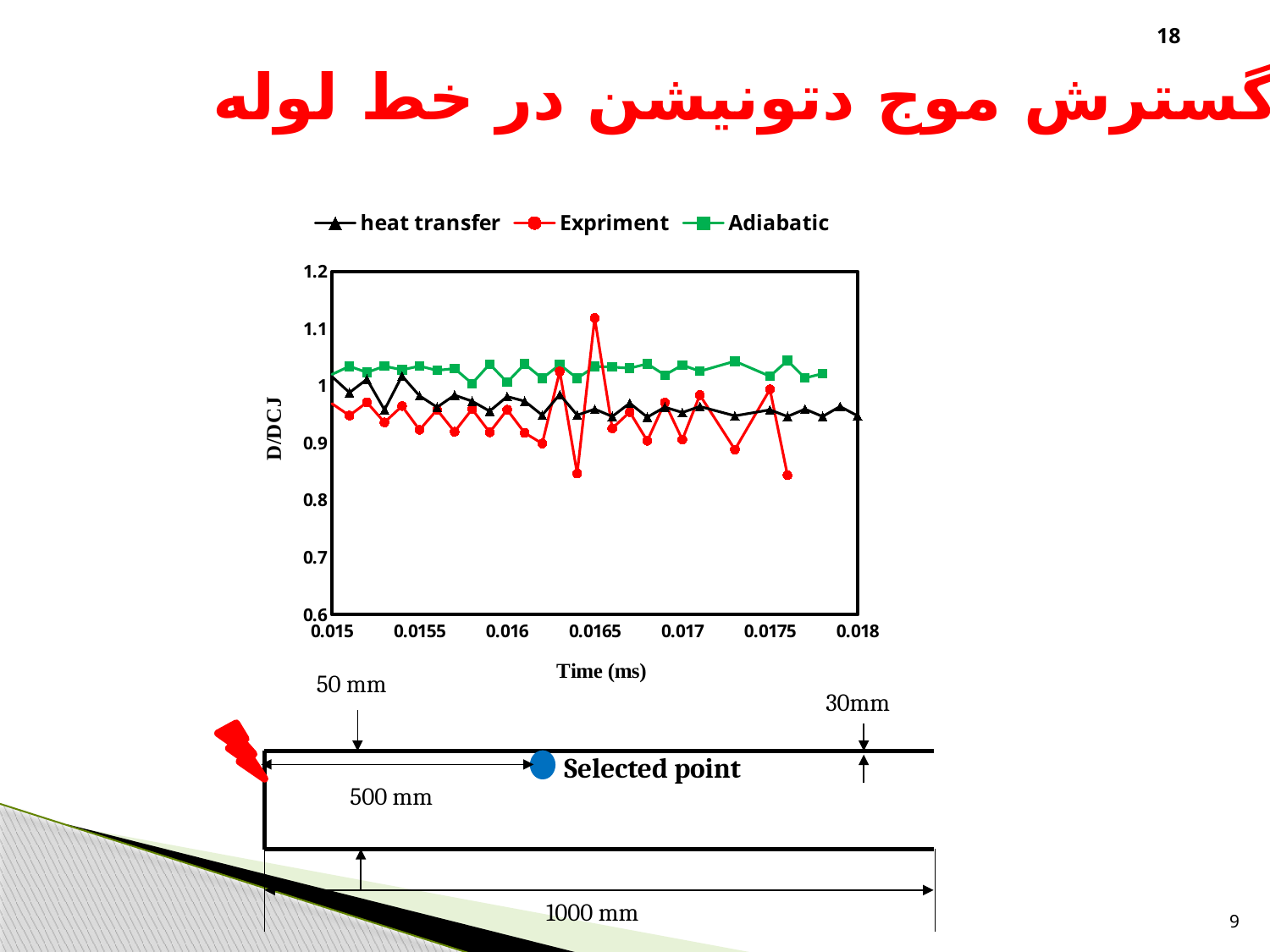
How many tick labels are shown on the chart's Time (ms) axis? 7 At time 0.015 ms, which series has the larger D/DCJ value, Adiabatic or Expriment? Adiabatic How many series does the chart legend list? 3 Which series in the chart generally has the highest D/DCJ values across the time range? Adiabatic Is the Adiabatic value at time 0.015 ms greater or less than 1? greater What kind of chart is shown on the slide? Line chart Is the lowest Expriment value in the chart greater or less than 0.9? less What is the maximum value shown on the chart's vertical axis? 1.2 What are the three series named in the chart legend? heat transfer, Expriment, Adiabatic What is the label of the chart's vertical axis? D/DCJ Is the highest Expriment value in the chart greater or less than 1? greater Which series in the chart contains the lowest plotted D/DCJ value? Expriment